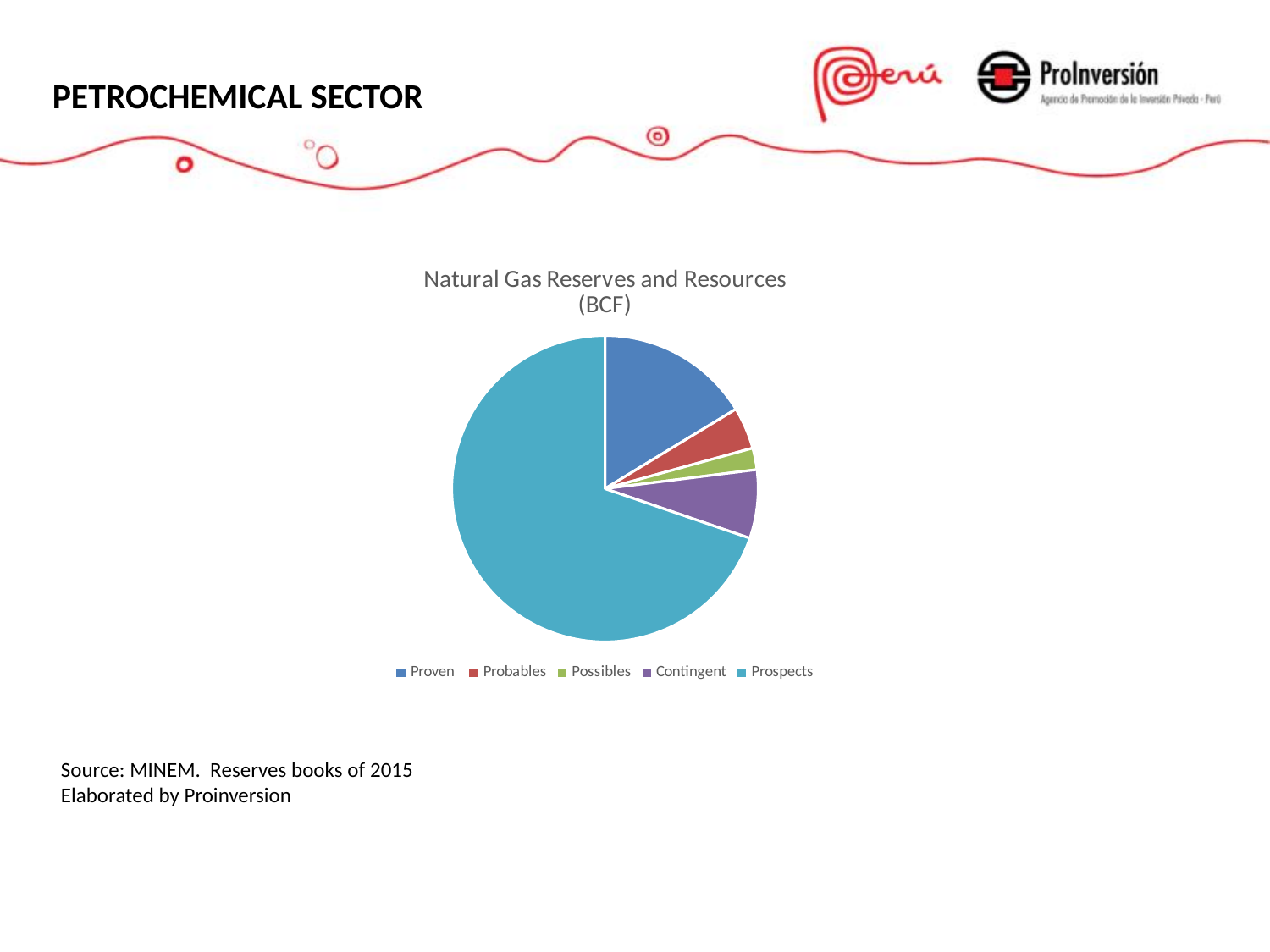
Which slice is larger, Contingent or Possibles? Contingent Which category has the largest slice of the pie? Prospects Which category has the smallest slice of the pie? Possibles Which slice is larger, Proven or Contingent? Proven Which category is shown in green in the pie chart? Possibles What is the title of the chart? Natural Gas Reserves and Resources (BCF) What kind of chart is shown on the slide? pie chart Which slice is larger, Prospects or Proven? Prospects How many categories (slices) does the pie chart have? 5 How many entries does the legend list? 5